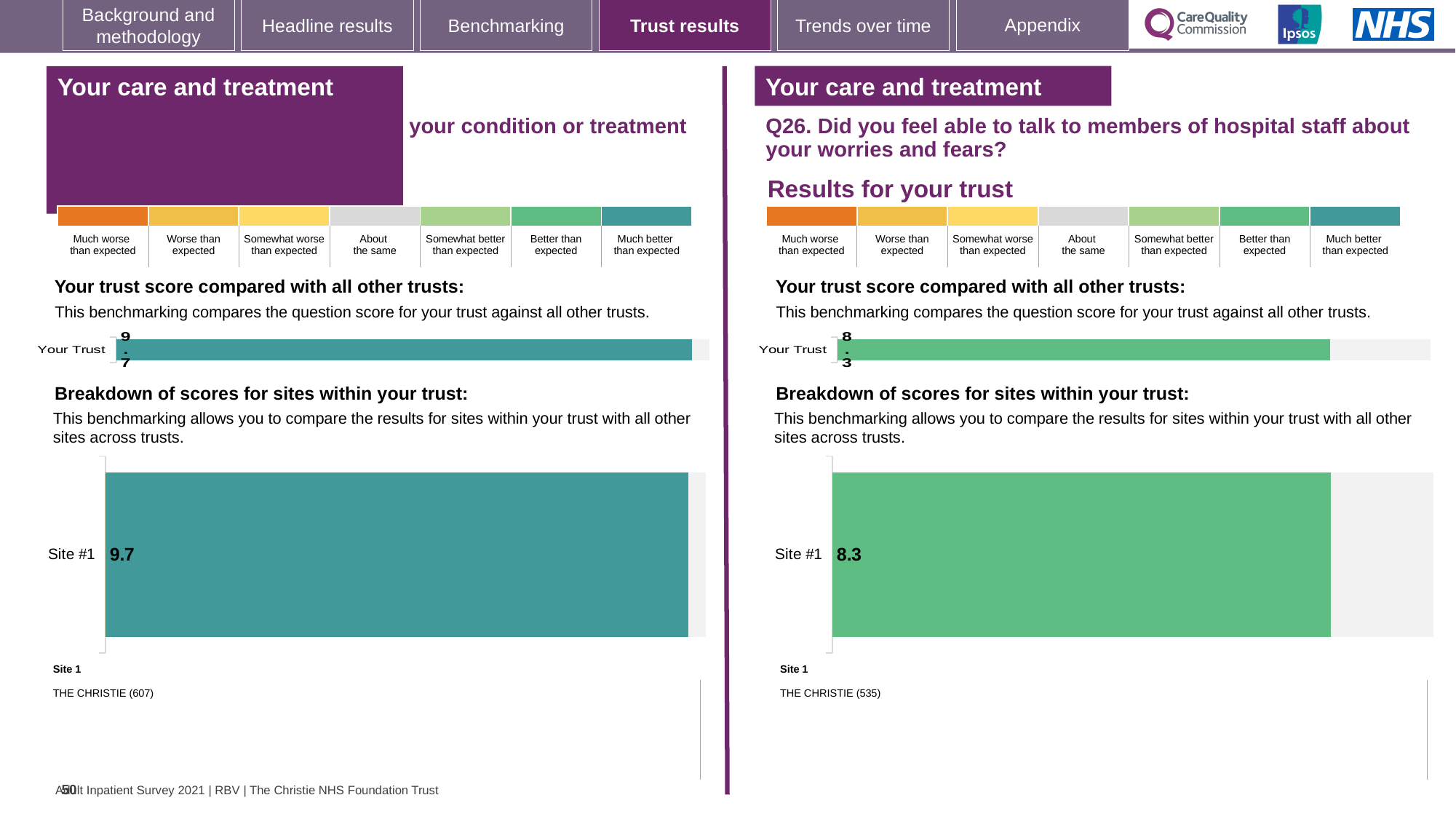
How many sites are plotted in the right-hand 'Breakdown of scores for sites within your trust' chart? 1 In the left-hand site breakdown chart, what colour is the Site #1 bar? Teal What is the difference between the Site #1 score in the left-hand site breakdown chart and the Site #1 score in the right-hand site breakdown chart? 1.4 In the right-hand site breakdown chart (Q26), what colour is the Site #1 bar? Green On the right half of the slide (Q26), what is the 'Your Trust' score shown in the trust benchmarking bar chart? 8.3 Which is larger: the 'Your Trust' score on the left half of the slide or the 'Your Trust' score on the right half (Q26)? Left half (9.7) On the left half of the slide, what is the 'Your Trust' score shown in the trust benchmarking bar chart? 9.7 In the left-hand 'Breakdown of scores for sites within your trust' chart, what is the score for Site #1? 9.7 Which site name is listed under 'Site 1' beneath the right-hand site breakdown chart (Q26)? THE CHRISTIE (535) In the right-hand 'Breakdown of scores for sites within your trust' chart (Q26), what is the score for Site #1? 8.3 How many sites are plotted in the left-hand 'Breakdown of scores for sites within your trust' chart? 1 What type of chart is used to show the 'Your Trust' score on each half of the slide? Bar chart